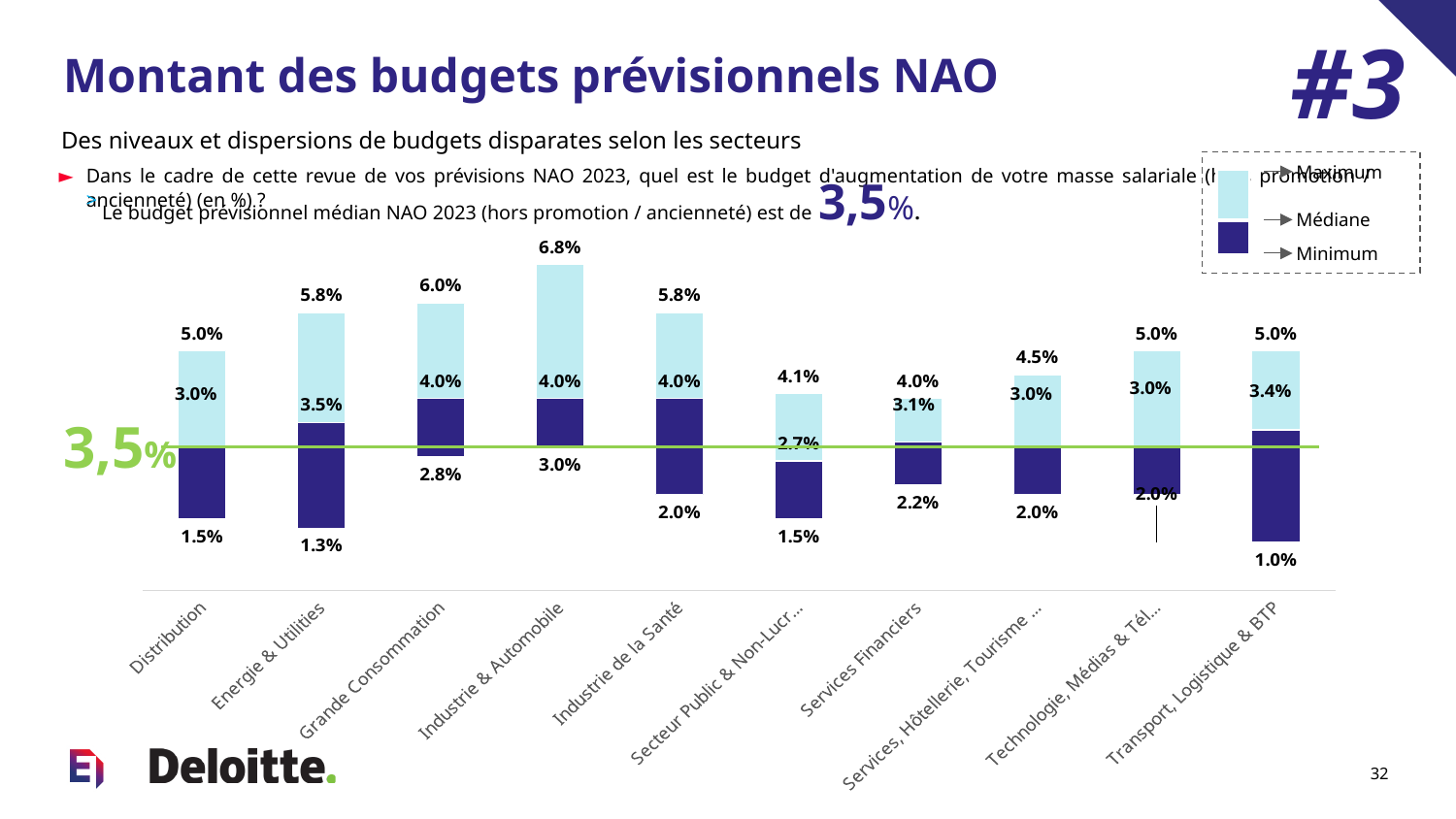
What is the median budget value shown for Services Financiers? 3.1% Which sector has the lowest minimum budget value? Transport, Logistique & BTP What is the median budget value shown for Transport, Logistique & BTP? 3.4% How many series does the chart legend list? 3 What is the difference between the maximum and minimum budget values for Distribution? 3.5% How many sectors are shown on the x axis of the chart? 10 What is the maximum budget value shown for Industrie & Automobile? 6.8% Which sector has the highest maximum budget value? Industrie & Automobile What value does the green horizontal line across the chart represent? 3,5% Which is larger, the maximum value for Grande Consommation or the maximum value for Industrie de la Santé? Grande Consommation What kind of chart is shown on the slide? Bar chart What is the minimum budget value shown for Energie & Utilities? 1.3%